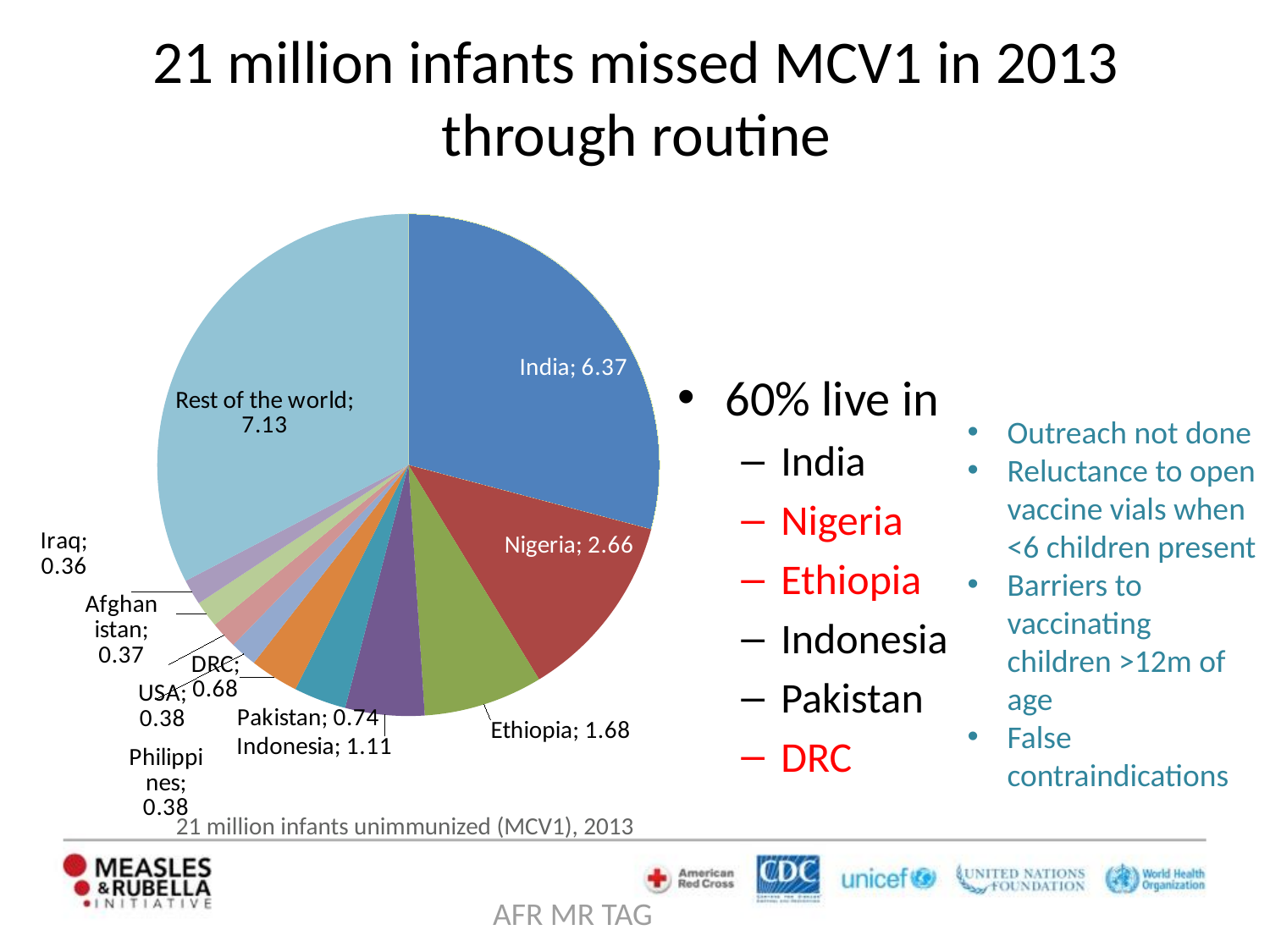
Which slice of the pie chart is the largest? Rest of the world Which has a larger value in the pie chart, Indonesia or Pakistan? Indonesia What is the title printed below the pie chart? 21 million infants unimmunized (MCV1), 2013 How many slices does the pie chart have? 11 What is the difference between the values for India and Nigeria in the pie chart? 3.71 What type of chart is shown on the slide? Pie chart What is the value shown for Rest of the world in the pie chart? 7.13 What is the value shown for DRC in the pie chart? 0.68 What is the value shown for India in the pie chart? 6.37 Which individual country has the largest slice in the pie chart? India What is the value shown for Nigeria in the pie chart? 2.66 What is the value shown for Ethiopia in the pie chart? 1.68